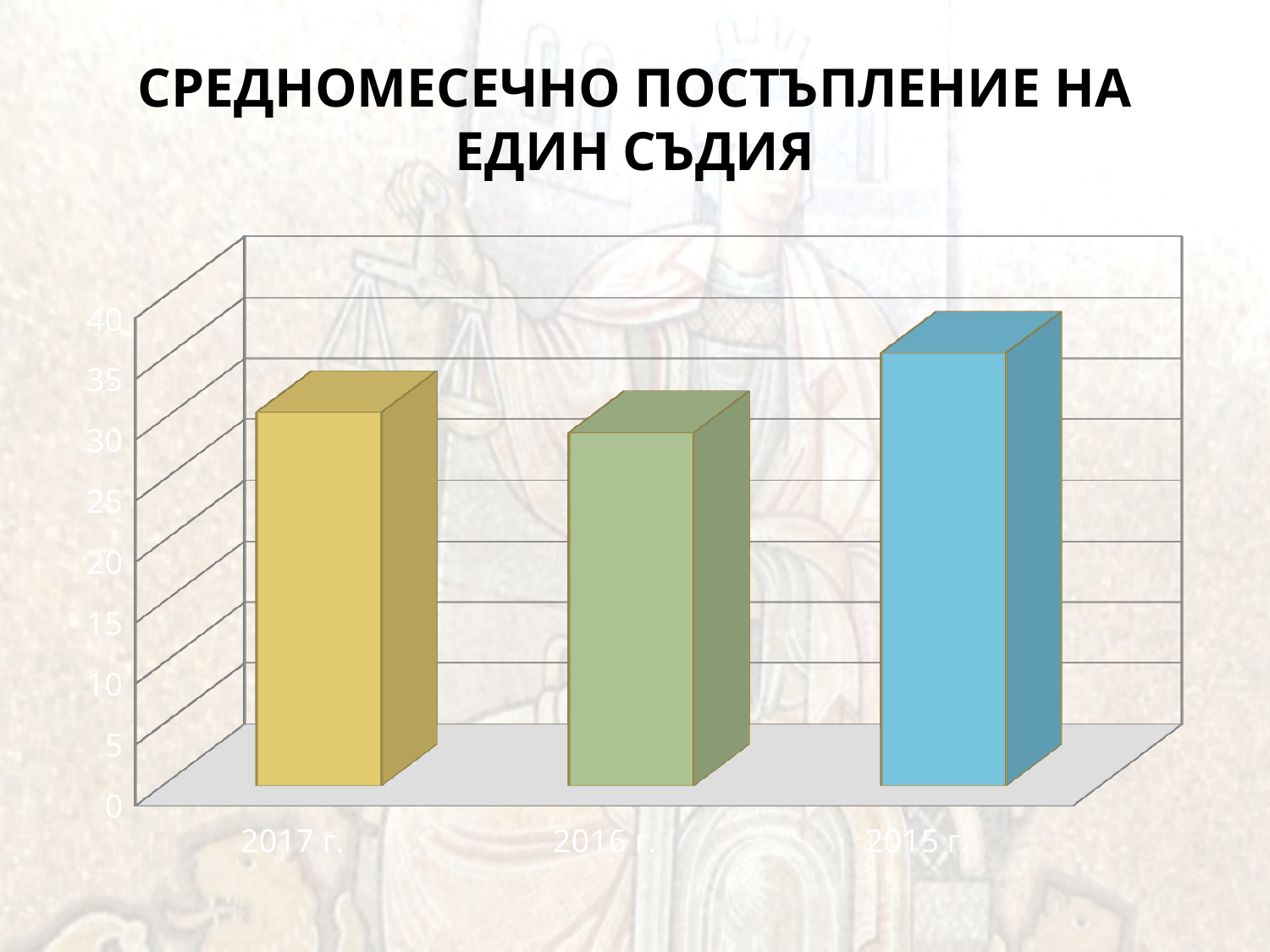
Does the value rise or fall from 2016 г. to 2015 г. along the x axis? rises Which category has the lowest value? 2016 г. Is the value for 2016 г. greater or less than 35? less Is the value for 2017 г. greater or less than 35? less Is the value for 2016 г. greater or less than 25? greater How many bars (categories) does the chart show? 3 Which category has the highest value? 2015 г. What is the title of the chart on the slide? СРЕДНОМЕСЕЧНО ПОСТЪПЛЕНИЕ НА ЕДИН СЪДИЯ Which is larger, the value for 2015 г. or the value for 2016 г.? 2015 г. What kind of chart is shown on the slide? bar chart What is the highest tick value shown on the vertical axis? 40